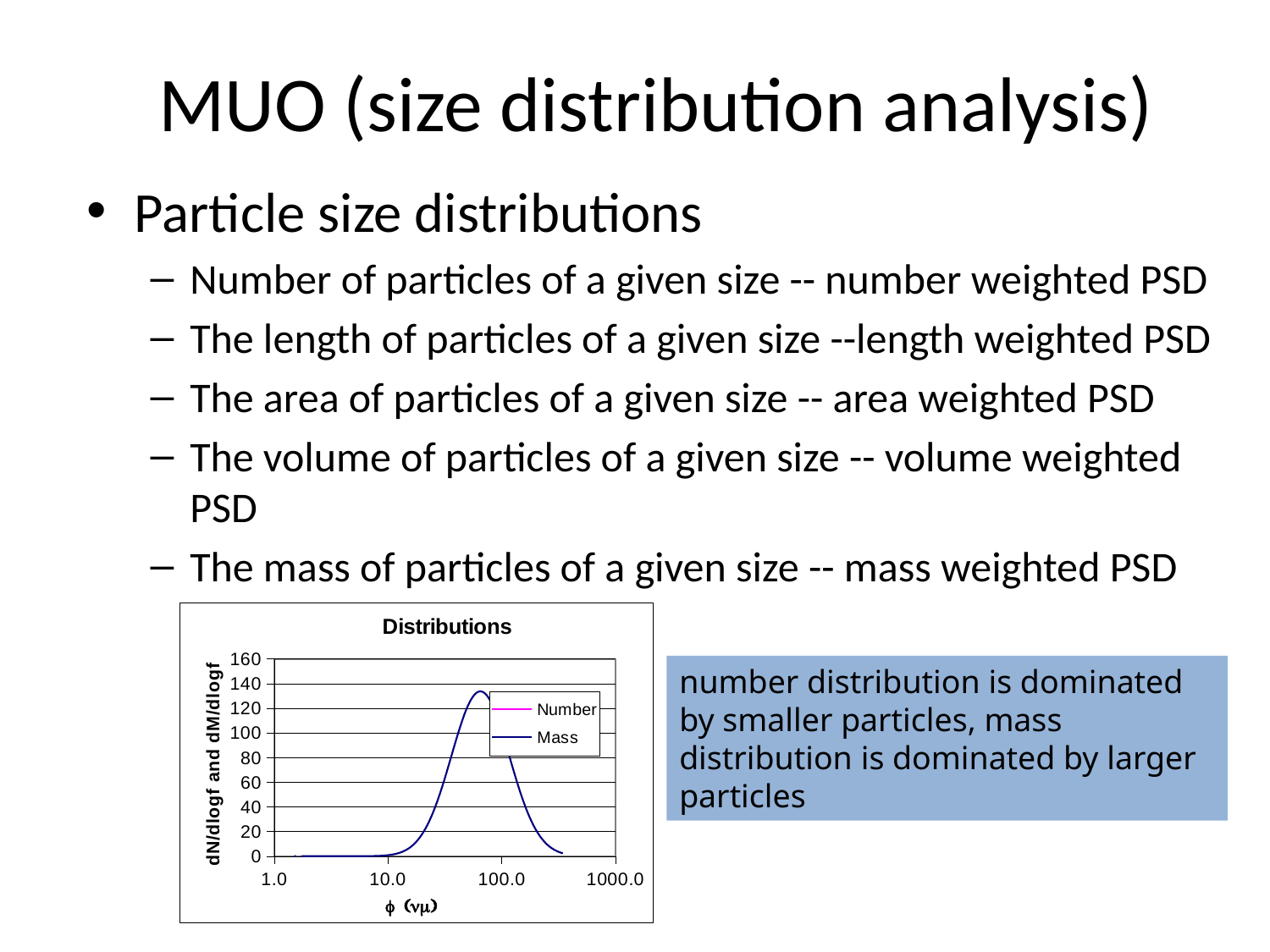
How many series does the legend of the "Distributions" chart list? 2 How many tick labels are shown on the x axis of the chart? 4 Is the value of the Mass curve at 10.0 greater or less than 20? less What is the highest value shown on the y axis of the chart? 160 Is the peak value of the Mass curve greater or less than 140? less What kind of chart is shown on the slide? line chart Is the peak value of the Mass curve greater or less than 120? greater Which two series are listed in the chart's legend? Number and Mass What is the title of the chart on the slide? Distributions What is the largest value labelled on the x axis of the chart? 1000.0